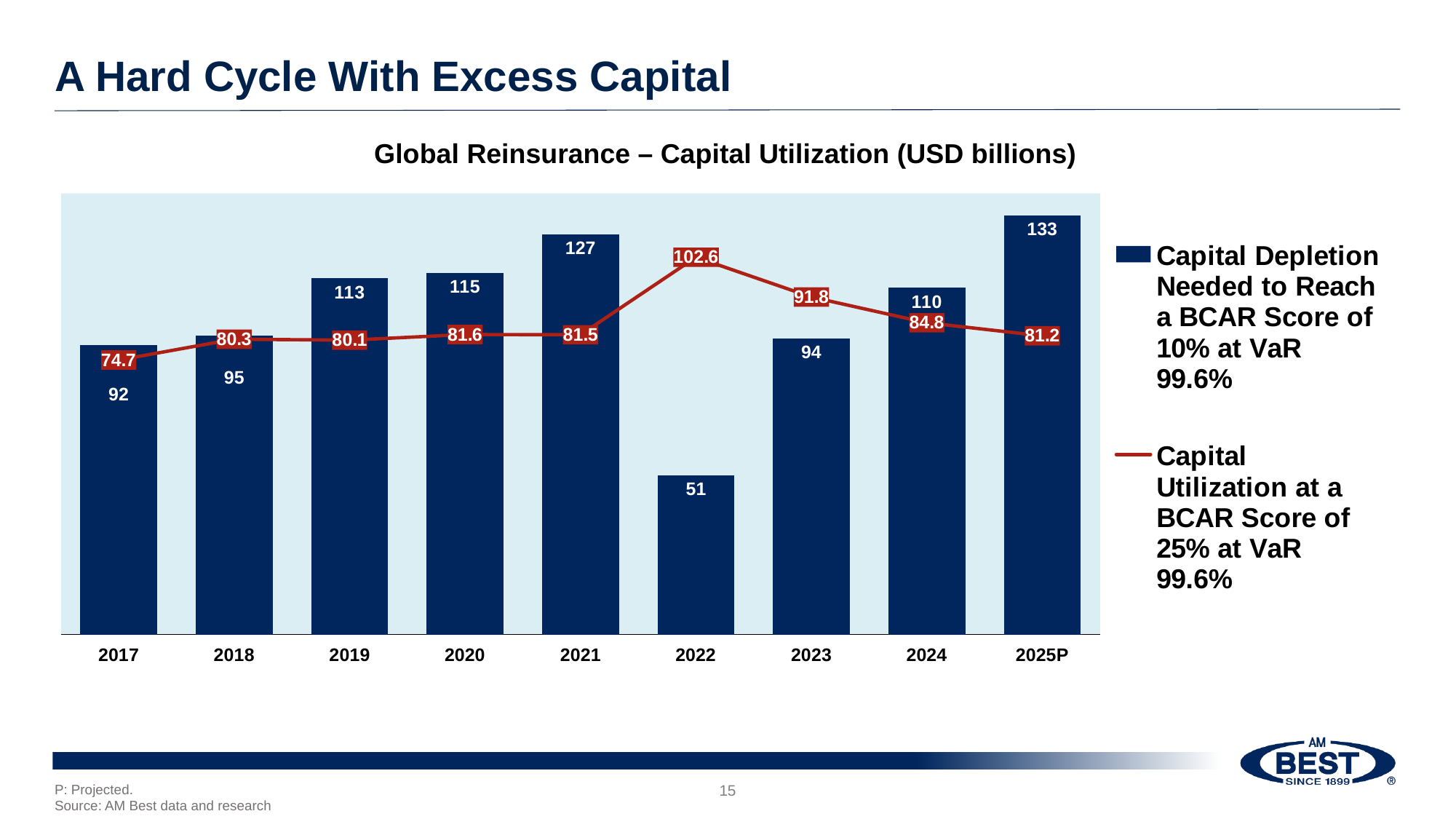
Which year has the lowest Capital Depletion Needed to Reach a BCAR Score of 10% at VaR 99.6%? 2022 What kind of chart is used for the Capital Depletion Needed series? Bar chart What is the Capital Depletion Needed to Reach a BCAR Score of 10% at VaR 99.6% for 2025P? 133 What is the Capital Depletion Needed to Reach a BCAR Score of 10% at VaR 99.6% for 2021? 127 What is the Capital Utilization at a BCAR Score of 25% at VaR 99.6% for 2022? 102.6 What is the difference between the Capital Depletion Needed values for 2025P and 2022? 82 Which year has the highest Capital Utilization at a BCAR Score of 25% at VaR 99.6%? 2022 Which year has the lowest Capital Utilization at a BCAR Score of 25% at VaR 99.6%? 2017 What is the title of the chart? Global Reinsurance – Capital Utilization (USD billions) Is the Capital Depletion Needed value larger in 2019 or in 2024? 2019 How many series does the legend list? 2 How many years are shown on the x axis? 9